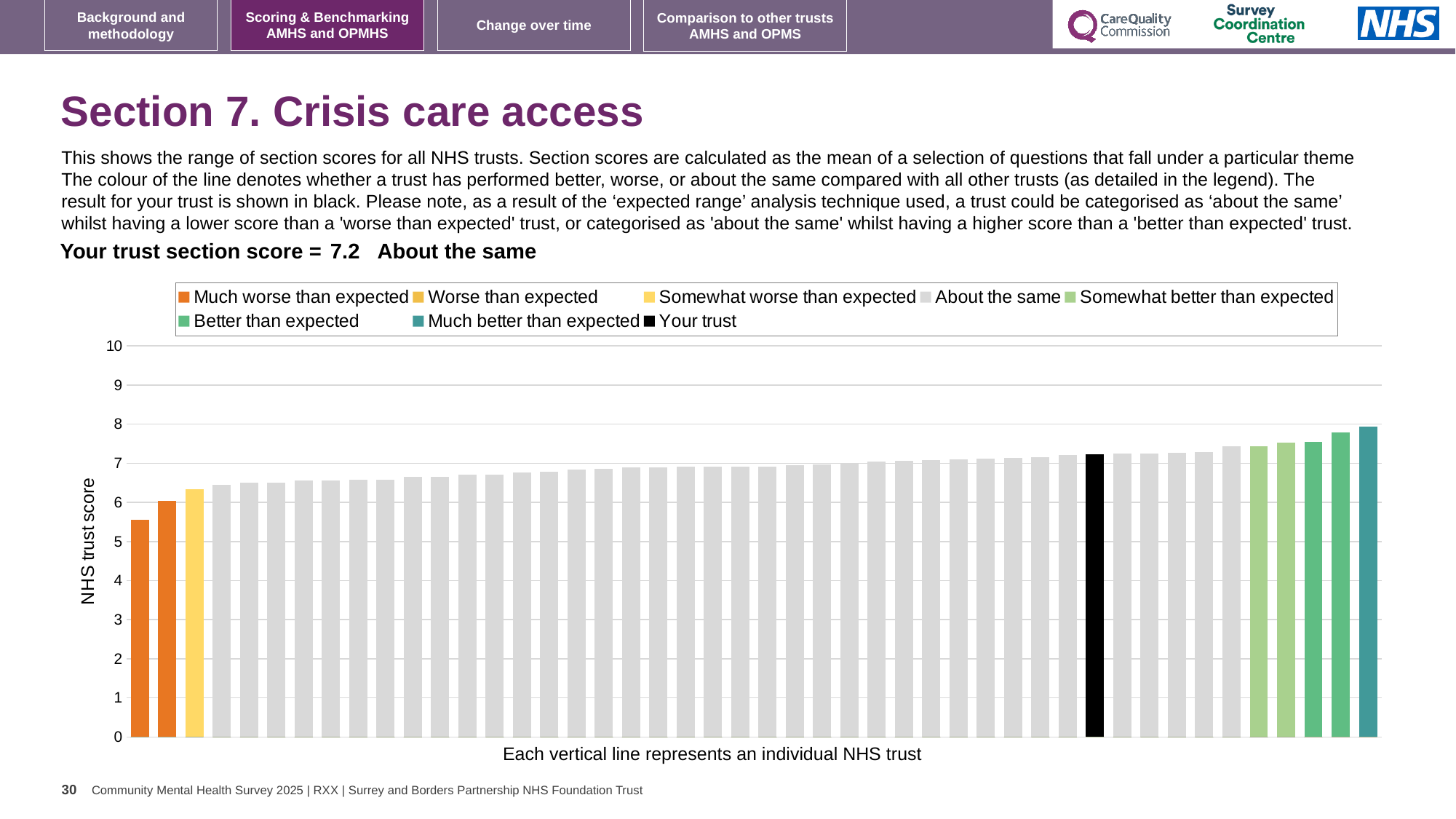
What is the section score for your trust (the black bar)? 7.2 What kind of chart is shown on the slide? bar chart Is the value of the highest bar in the chart greater or less than 7? greater Which legend category does the tallest bar belong to? Much better than expected What is the label on the vertical axis of the chart? NHS trust score Which legend category does the shortest bar belong to? Much worse than expected How many bars are coloured orange (Much worse than expected)? 2 Which category is your trust placed in according to the text above the chart? About the same Is the value of the lowest bar in the chart greater or less than 6? less Is the value for your trust (the black bar) greater or less than 7? greater How many entries does the chart legend list? 8 Do the bar values rise or fall from left to right along the x axis? rise